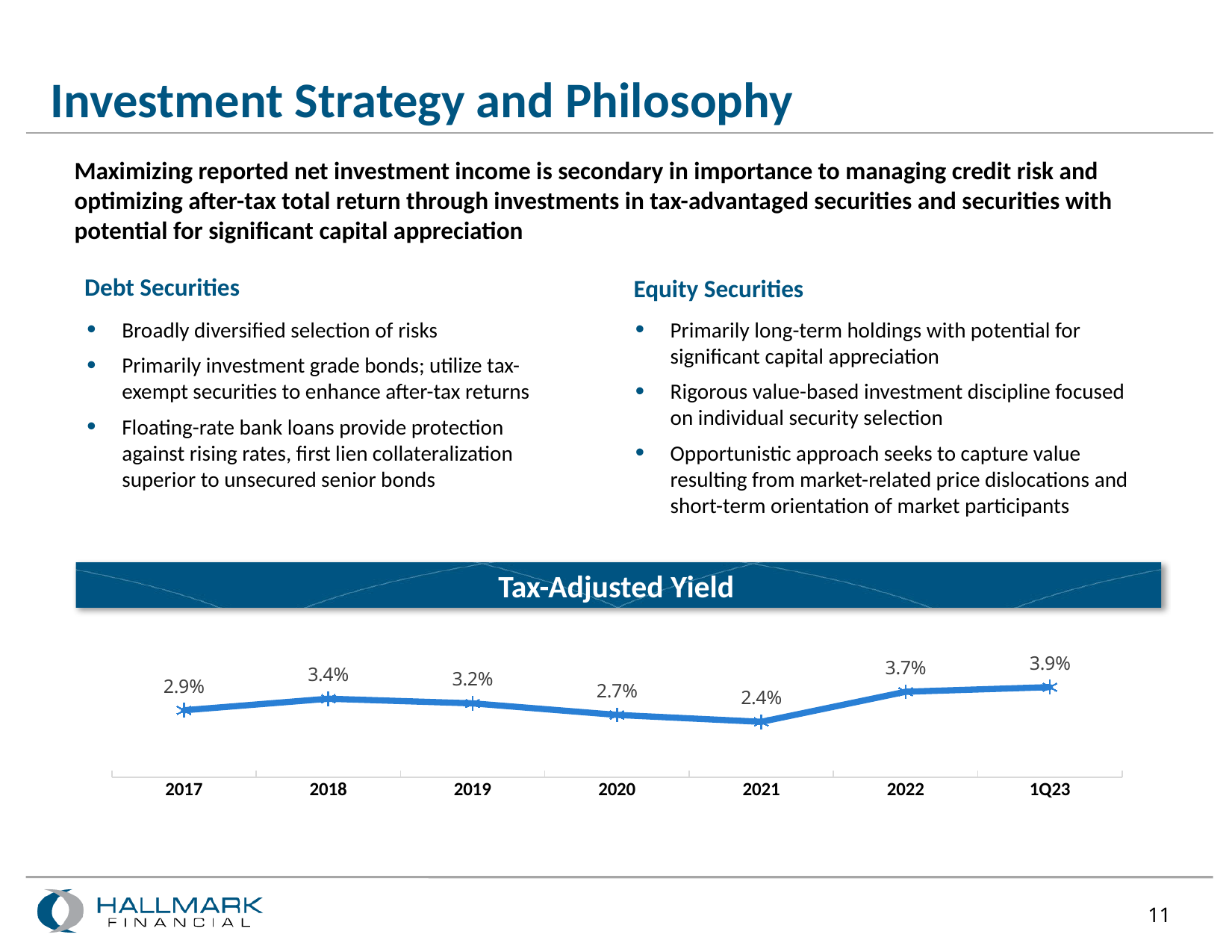
What is the title of the chart on the slide? Tax-Adjusted Yield What is the tax-adjusted yield for 2021? 2.4% What kind of chart is the Tax-Adjusted Yield chart? Line chart Which period has the lowest tax-adjusted yield? 2021 What is the difference between the tax-adjusted yield in 1Q23 and in 2021? 1.5% Which is larger, the tax-adjusted yield in 2018 or in 2020? 2018 Which period has the highest tax-adjusted yield? 1Q23 What is the difference between the tax-adjusted yield in 2018 and in 2019? 0.2% What is the tax-adjusted yield for 1Q23? 3.9% How many periods are plotted in the Tax-Adjusted Yield chart? 7 Does the tax-adjusted yield rise or fall from 2021 to 1Q23? Rise What is the tax-adjusted yield for 2017? 2.9%